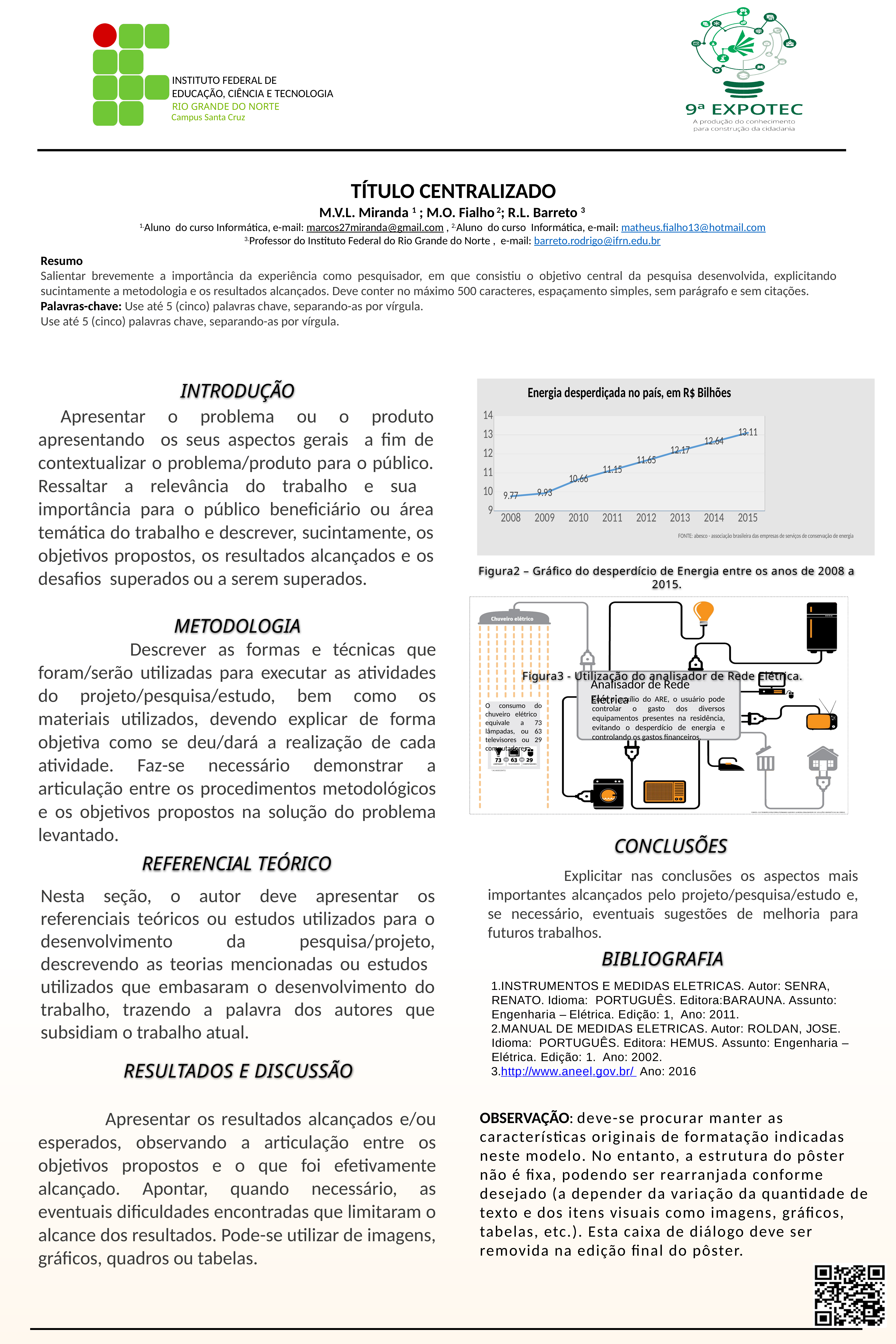
How many years are plotted in the chart? 8 Which year has the highest value in the chart? 2015 What kind of chart is shown on the slide? line chart What is the value for 2008 in the chart? 9.77 What is the difference between the values for 2015 and 2008 in the chart? 3.34 Which is larger in the chart, the value for 2010 or the value for 2013? 2013 Do the values in the chart rise or fall from 2008 to 2015? rise Which year has the lowest value in the chart? 2008 What is the difference between the values for 2011 and 2010 in the chart? 0.49 What is the value for 2012 in the chart? 11.65 What is the value for 2015 in the chart? 13.11 What is the title of the chart on the slide? Energia desperdiçada no país, em R$ Bilhões